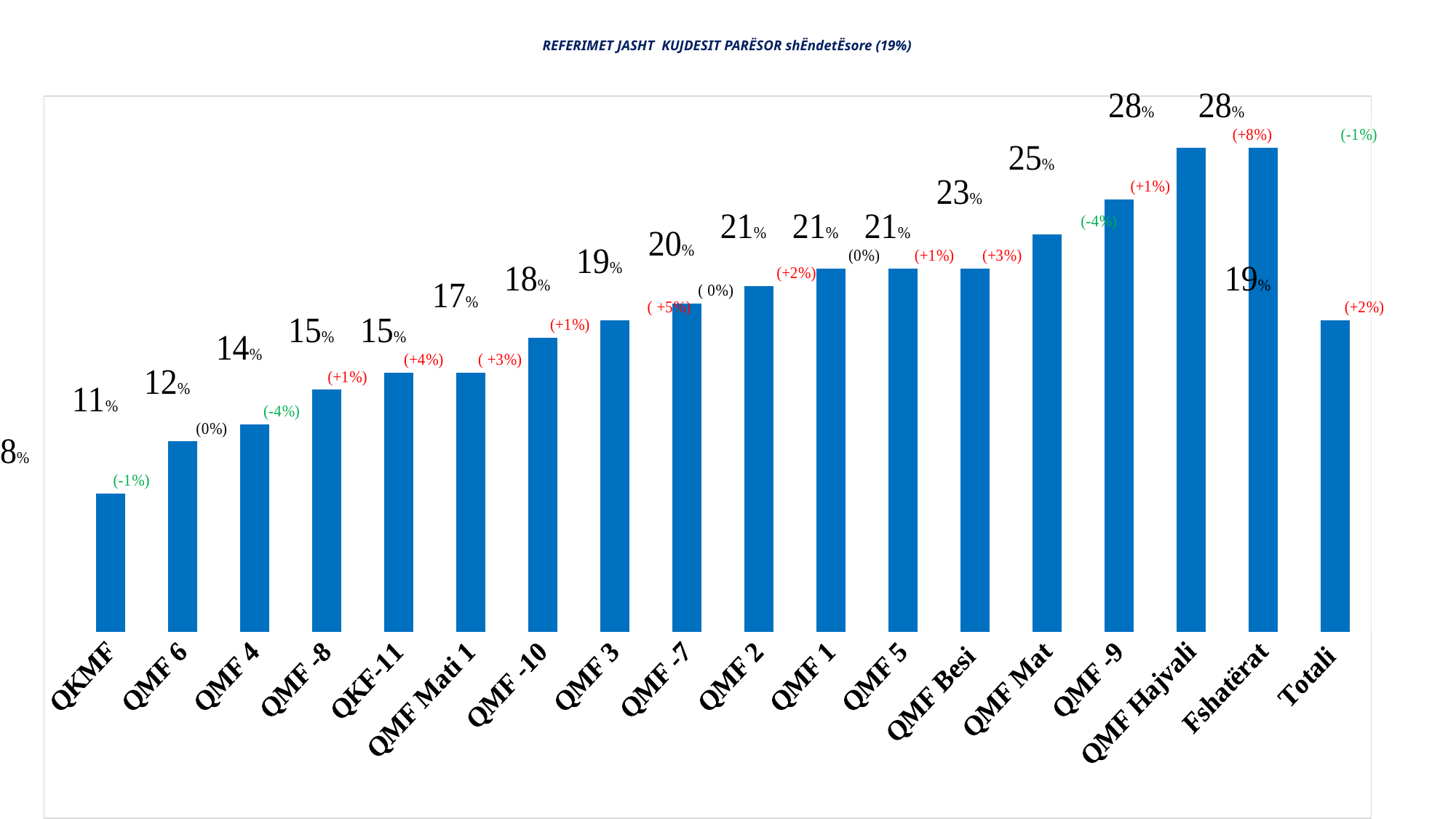
What is the value for QMF -9? 25% What is the value for QKMF? 8% What is the title of the chart? REFERIMET JASHT KUJDESIT PARËSOR shËndetËsore (19%) Do the values generally rise or fall from QKMF to Fshatërat along the x axis? rise What is the value for Totali? 19% Which two categories share the highest value of 28%? QMF Hajvali and Fshatërat What is the difference between the values for QMF Hajvali and QKMF? 20% Which category has the lowest value? QKMF How many categories are shown on the x axis of the chart? 18 What type of chart is shown on the slide? bar chart What is the value for QMF Mat? 23% Which is larger, the value for QMF -9 or the value for QMF Mat? QMF -9